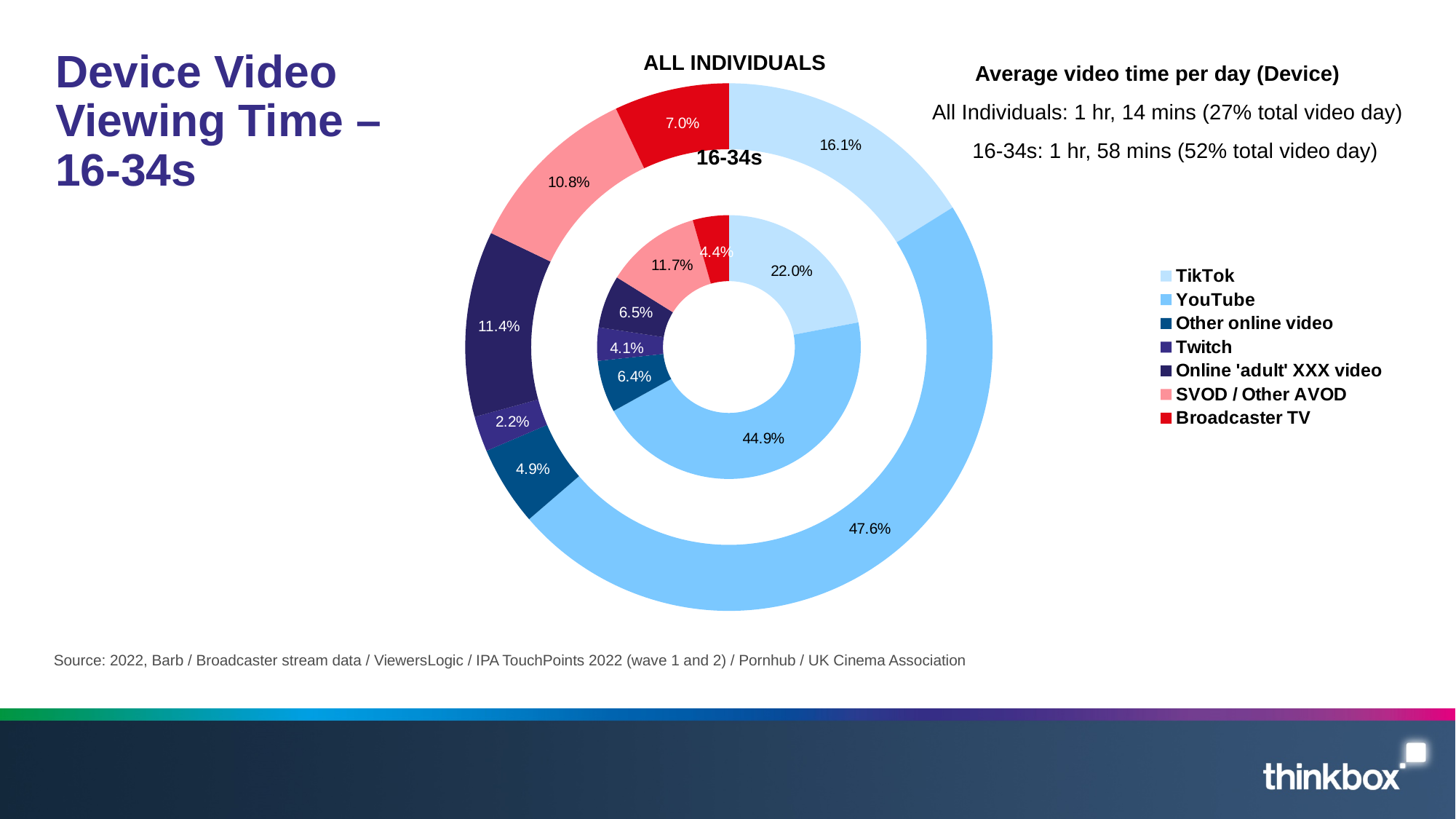
How many entries does the legend list? 7 In the inner ring (16-34s), what share does SVOD / Other AVOD account for? 11.7% Which category has the smallest share in the 16-34s ring? Twitch Which category has the smallest share in the All Individuals ring? Twitch Which category has the largest share in the All Individuals ring? YouTube What is the difference between the TikTok share for 16-34s (22.0%) and for All Individuals (16.1%)? 5.9% In the inner ring (16-34s), what share does TikTok account for? 22.0% Which ring of the doughnut represents 16-34s, the inner or the outer? Inner What kind of chart is shown on the slide? Doughnut chart Is the Online 'adult' XXX video share larger for All Individuals or for 16-34s? All Individuals In the outer ring (All Individuals), what share does YouTube account for? 47.6% In the outer ring (All Individuals), what share does Broadcaster TV account for? 7.0%